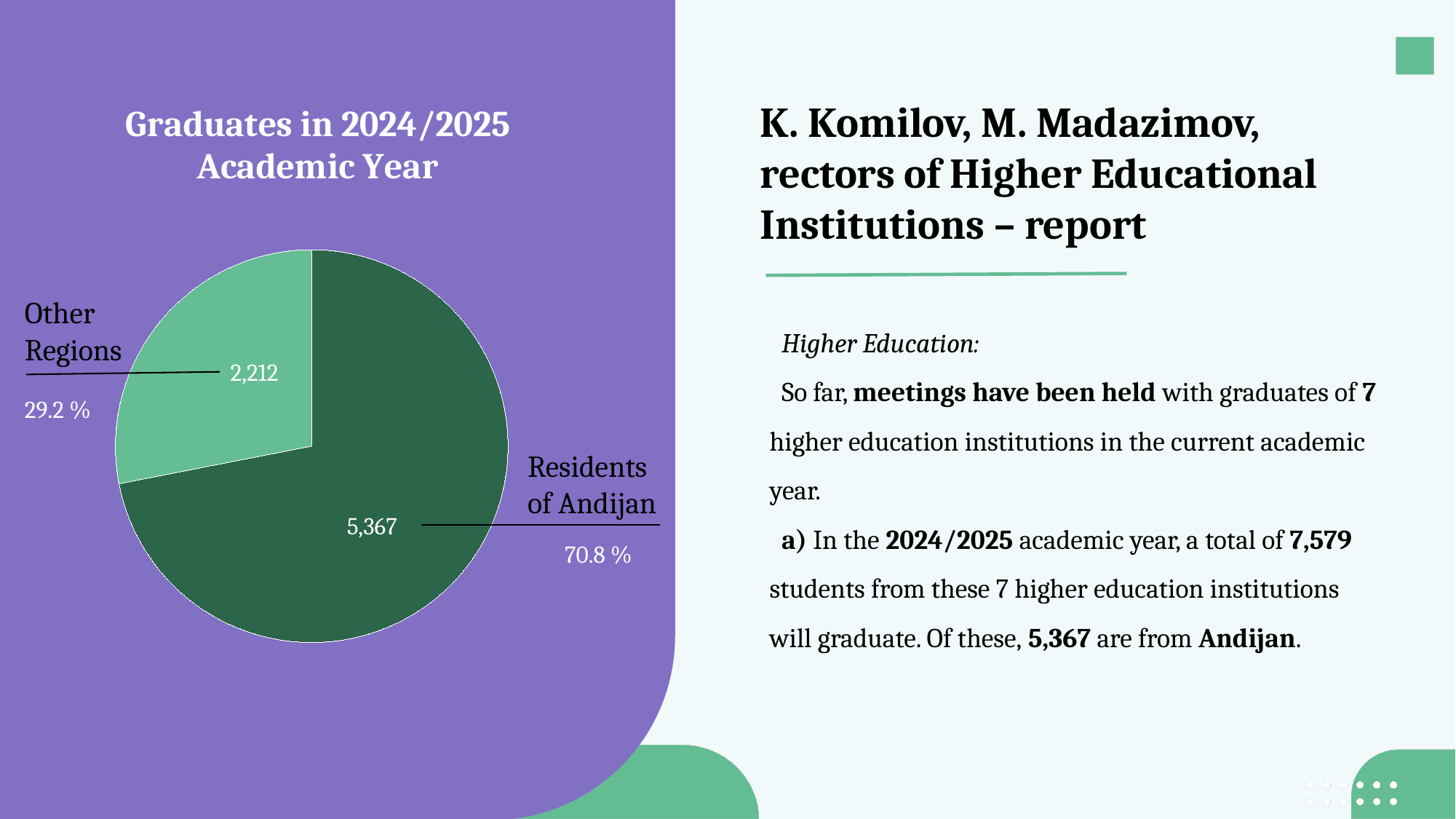
How many slices does the pie chart have? 2 How many graduates are from Other Regions according to the chart? 2,212 Which slice of the pie is the smallest? Other Regions What is the title of the chart? Graduates in 2024/2025 Academic Year What is the total number of graduates shown across both slices of the pie? 7,579 What is the difference between the number of graduates who are Residents of Andijan and those from Other Regions? 3,155 What kind of chart is shown on the slide? Pie chart Which slice of the pie is the largest? Residents of Andijan How many graduates are Residents of Andijan according to the chart? 5,367 Which is larger: the number of graduates from Other Regions or Residents of Andijan? Residents of Andijan What share of the pie do Other Regions make up? 29.2 % What share of the pie do Residents of Andijan make up? 70.8 %